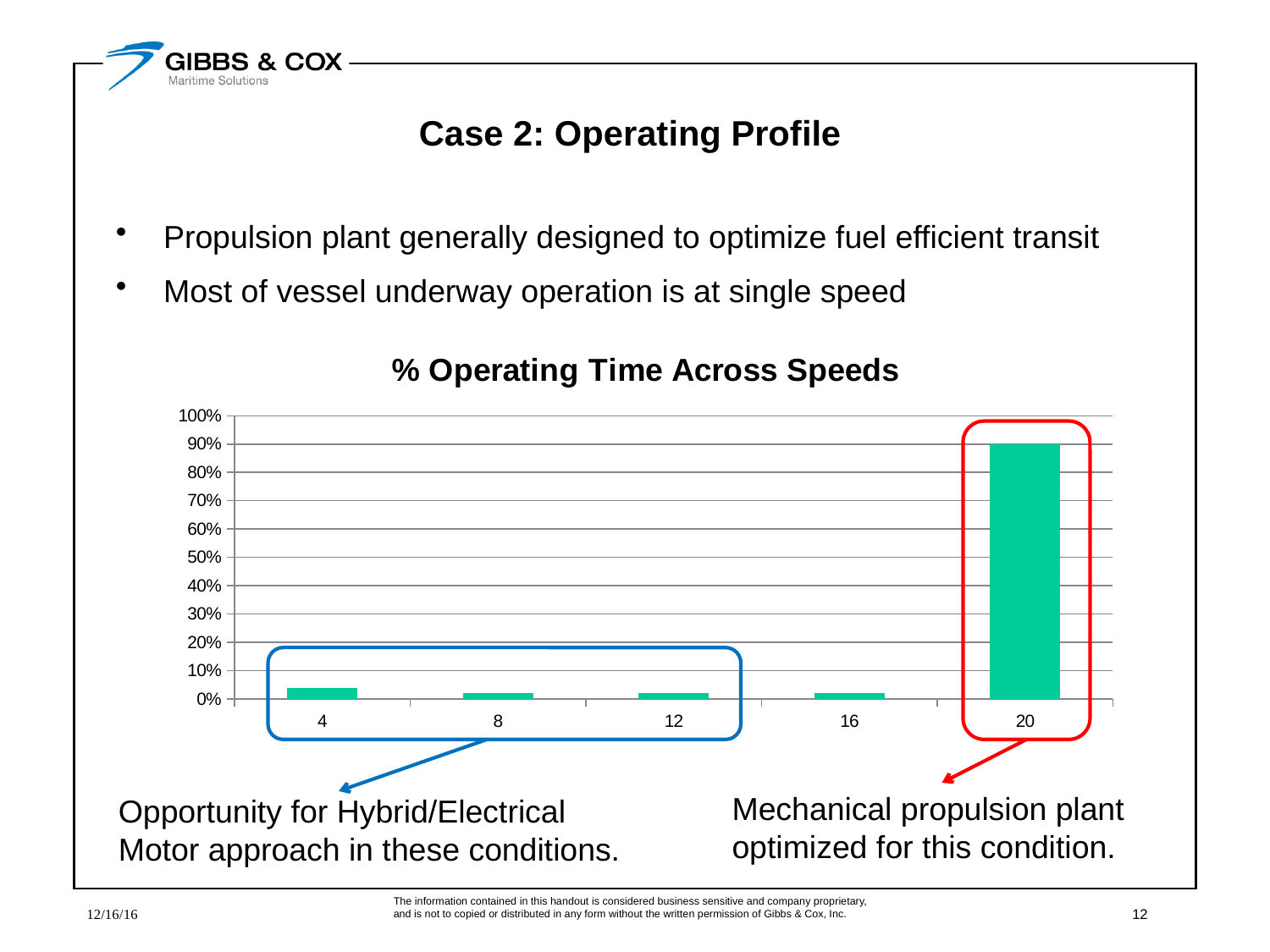
Is the value for speed 20 greater or less than 80%? greater Which is larger, the value for speed 12 or the value for speed 20? 20 Is the value for speed 8 greater or less than 50%? less Is the value for speed 16 greater or less than 10%? less What is the % operating time at speed 20? 90% What is the title of the chart? % Operating Time Across Speeds What is the highest value shown on the y axis of the chart? 100% Which is larger, the value for speed 4 or the value for speed 20? 20 Which speed has the highest % operating time? 20 What kind of chart is shown on the slide? bar chart How many speed categories are shown on the x axis of the chart? 5